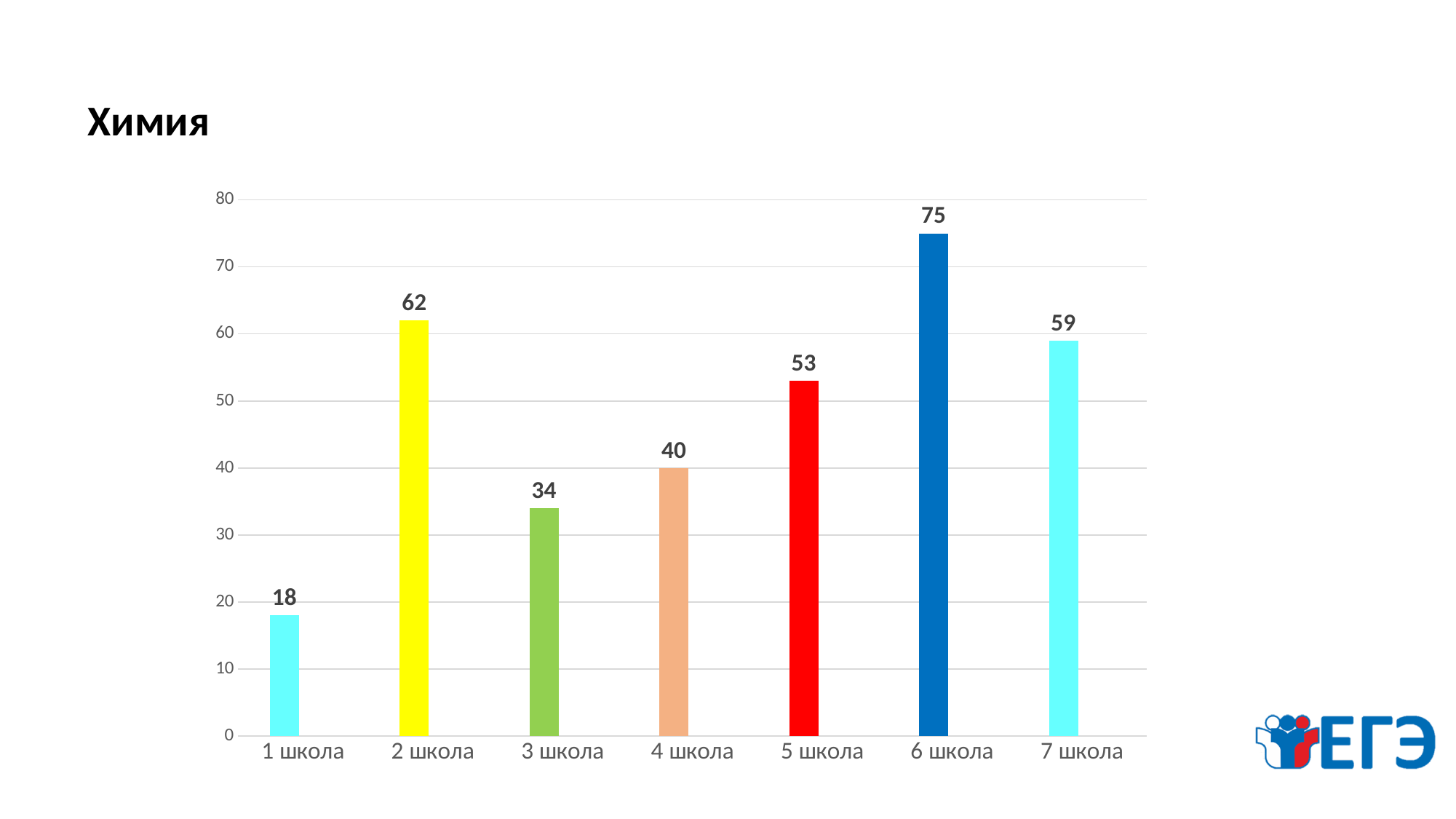
What is the title of the slide? Химия Is the value for 3 школа greater or less than 40? less What is the value for 1 школа? 18 What colour is the bar for 5 школа? red How many schools are shown on the chart? 7 What is the difference between the values for 2 школа and 3 школа? 28 Which is larger, the value for 5 школа or the value for 7 школа? 7 школа Which school has the lowest value? 1 школа What kind of chart is shown on the slide? bar chart What is the value for 4 школа? 40 What is the value for 6 школа? 75 Which school has the highest value? 6 школа